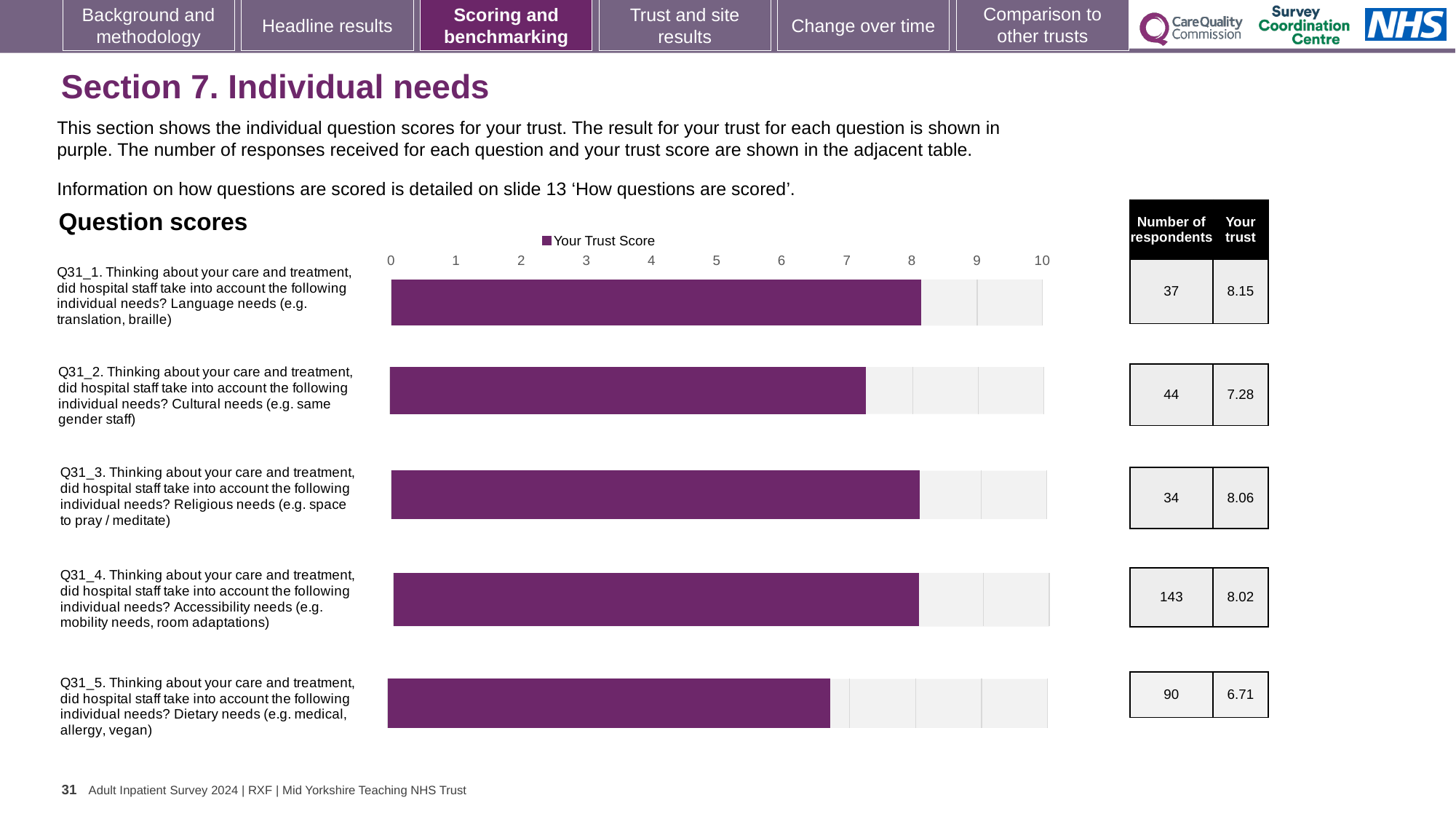
What type of chart is used to show the question scores? Bar chart What is the name of the series shown in the chart legend? Your Trust Score What is the difference between the trust scores for Q31_1 and Q31_5? 1.44 What is the trust score for Q31_5 (Dietary needs)? 6.71 How many questions are plotted in the chart? 5 Is the trust score for Q31_2 (Cultural needs) greater or less than 8? less How many series does the chart legend list? 1 How many respondents answered Q31_4 (Accessibility needs)? 143 Which has the larger trust score, Q31_2 (Cultural needs) or Q31_3 (Religious needs)? Q31_3 (Religious needs) Which question has the lowest trust score? Q31_5 (Dietary needs) What is the trust score for Q31_1 (Language needs)? 8.15 Which question has the highest trust score? Q31_1 (Language needs)